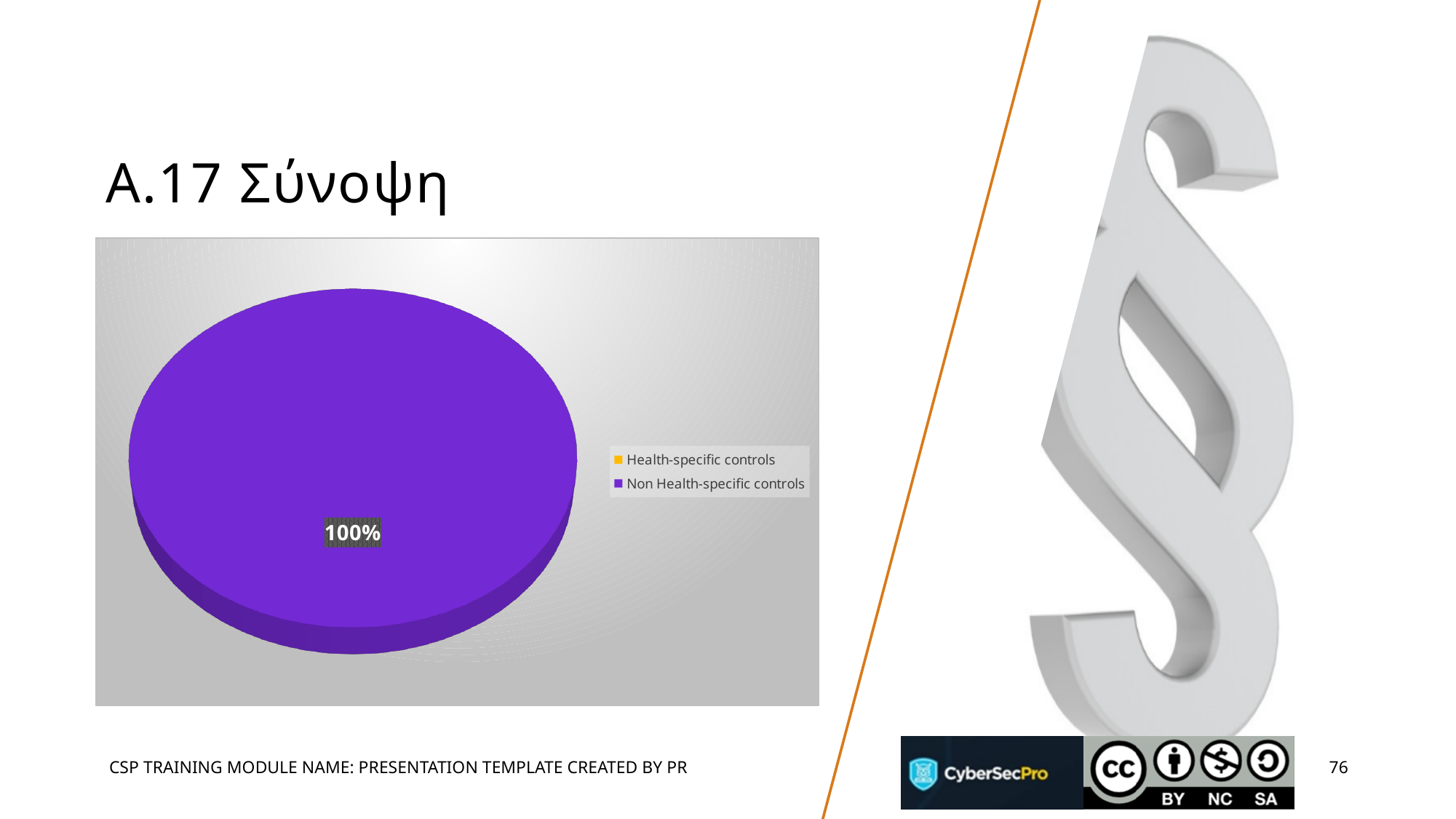
How many entries does the chart legend list? 2 Which category has the largest share of the pie? Non Health-specific controls What colour represents Non Health-specific controls in the chart? purple Which category has the smaller share of the pie, Health-specific controls or Non Health-specific controls? Health-specific controls What is the data label printed on the pie slice? 100% What kind of chart is shown on the slide? pie chart What share of the pie is labelled for Non Health-specific controls? 100% How many slices are visible in the pie chart? 1